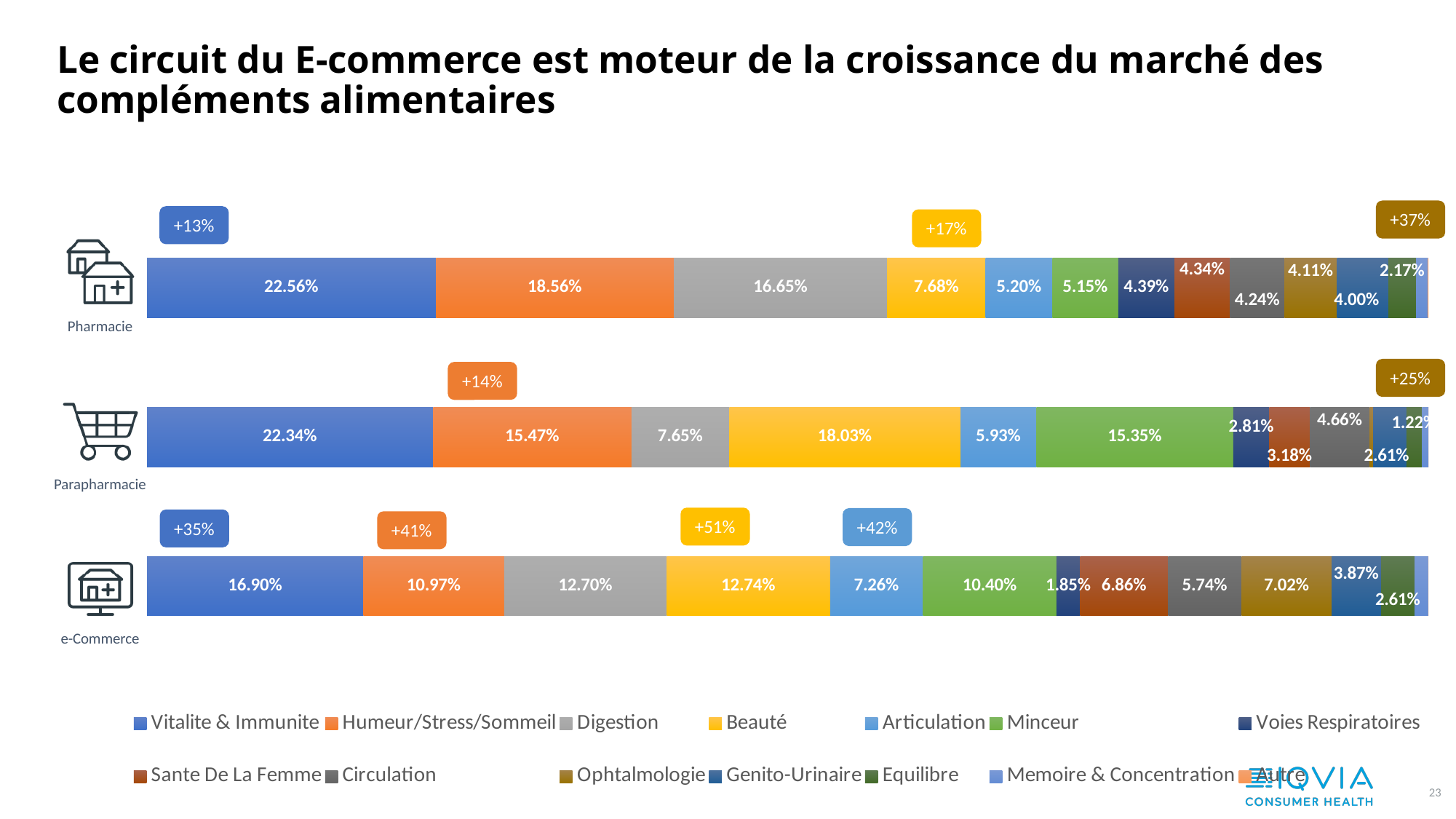
Is the Beauté share larger in Parapharmacie or in Pharmacie? Parapharmacie Which segment is the smallest labelled segment in the e-Commerce bar? Voies Respiratoires What is the share of Beauté in the Parapharmacie bar? 18.03% What is the share of Minceur in the e-Commerce bar? 10.40% How many series does the legend list? 14 What growth rate is shown above the Beauté segment of the e-Commerce bar? +51% What is the difference between the Vitalite & Immunite share in Pharmacie and in e-Commerce? 5.66 percentage points What is the share of Vitalite & Immunite in the Pharmacie bar? 22.56% Which segment is the largest in the Parapharmacie bar? Vitalite & Immunite What type of chart is shown on the slide? Stacked bar chart What is the share of Digestion in the e-Commerce bar? 12.70% How many channels (bars) are shown in the chart? 3